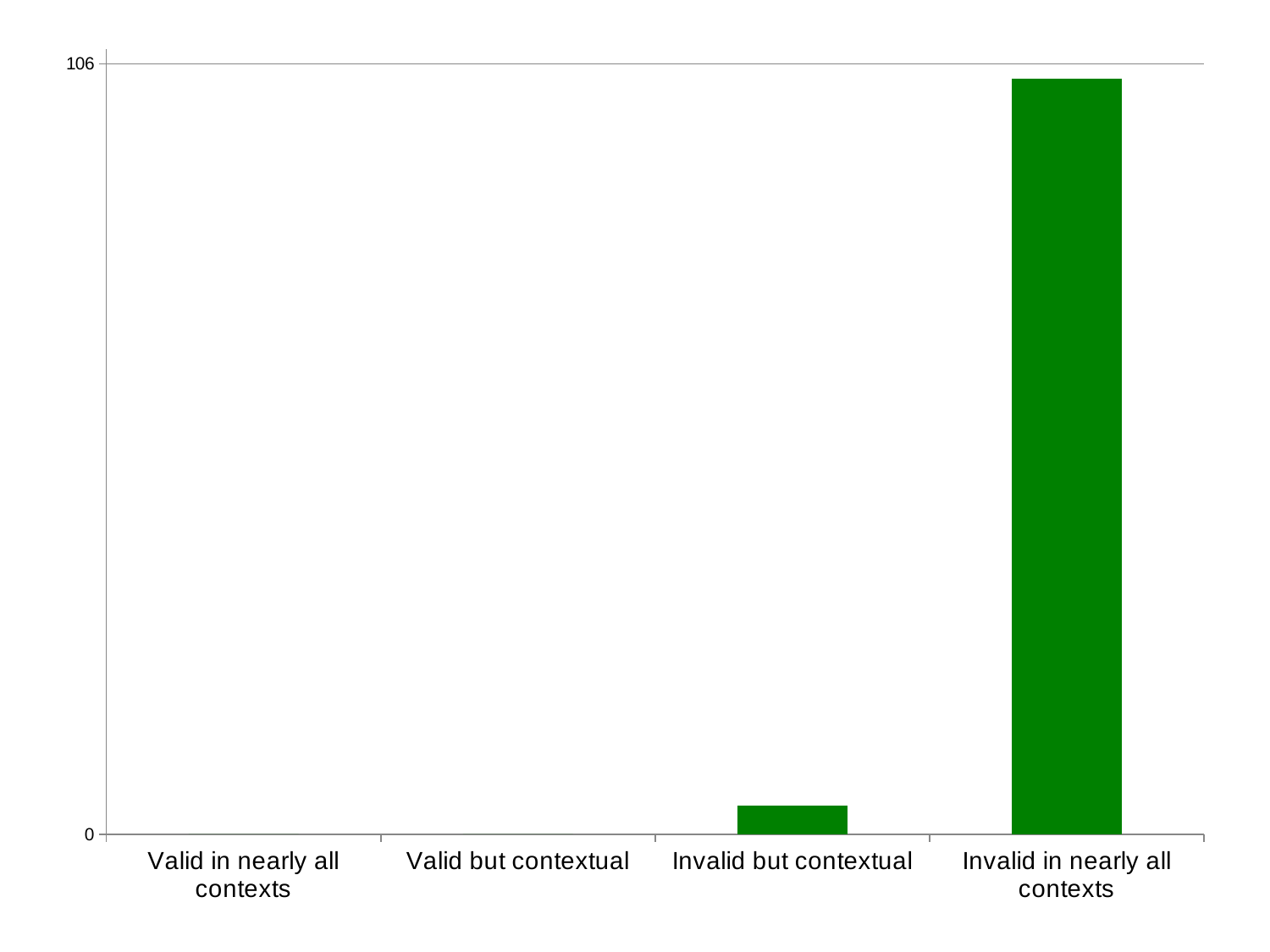
What colour are the bars in the chart? green Do the values rise or fall moving from left to right along the x axis? rise Which is larger, the value for Invalid but contextual or the value for Invalid in nearly all contexts? Invalid in nearly all contexts Which is larger, the value for Valid in nearly all contexts or the value for Invalid but contextual? Invalid but contextual What kind of chart is shown on the slide? bar chart What is the highest value shown on the y axis? 106 Is the value for Invalid but contextual greater or less than 0? greater Which category has the highest bar? Invalid in nearly all contexts How many categories are shown on the x axis? 4